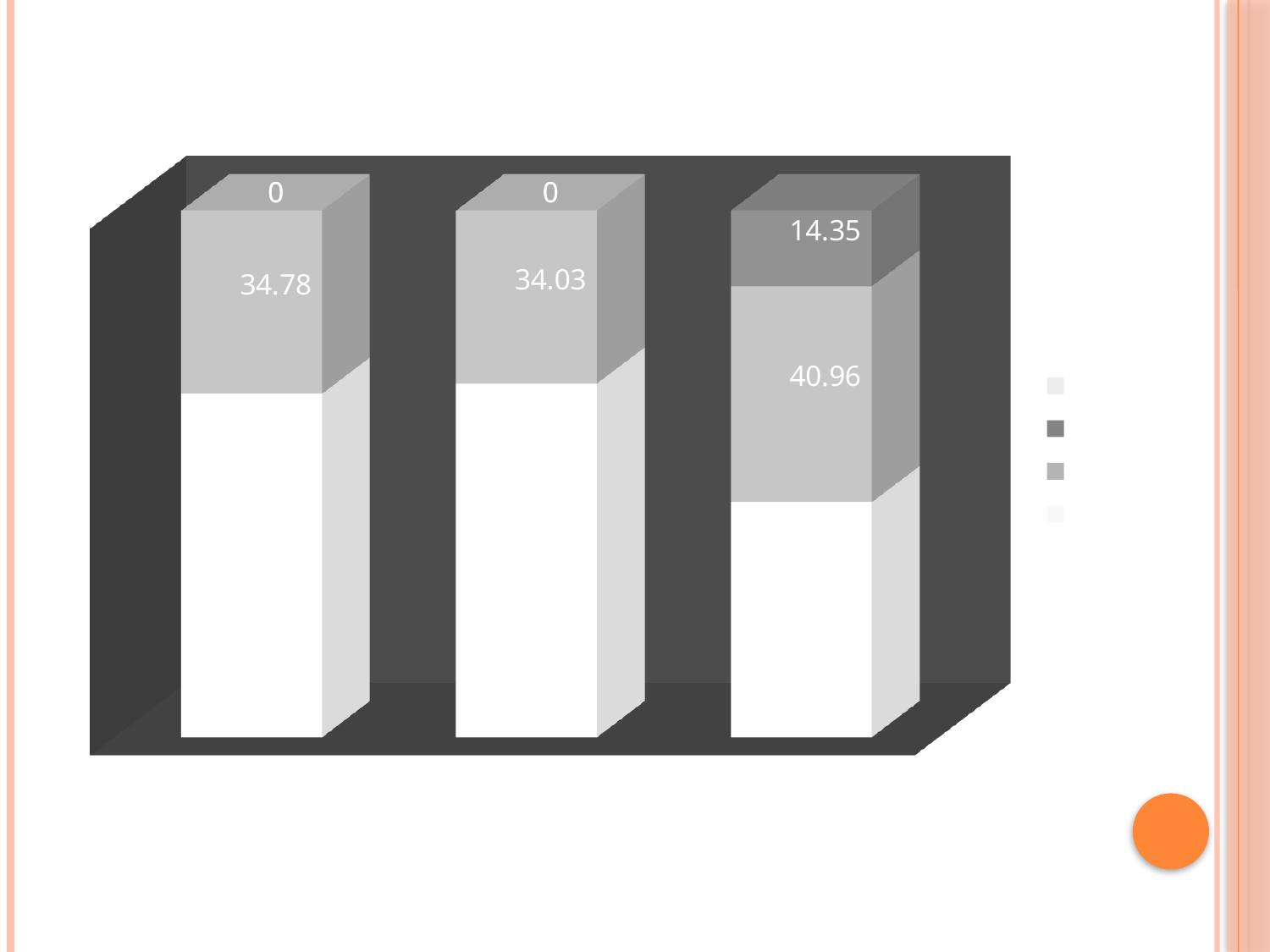
What is the difference between the light grey segment values of the right bar (40.96) and the left bar (34.78)? 6.18 What is the value labelled on the light grey segment of the middle bar? 34.03 Which bar has the lowest labelled light grey segment value? the middle bar Which is larger: the light grey segment value of the left bar or of the middle bar? the left bar How many entries does the legend on the right of the chart show? 4 What kind of chart is shown on the slide? bar chart Which bar has the highest labelled light grey segment value? the right bar How many bars are plotted in the chart? 3 What is the value labelled on the light grey segment of the right bar? 40.96 What is the value labelled on the dark grey top segment of the right bar? 14.35 What value is labelled at the top of the left bar? 0 What is the value labelled on the light grey segment of the left bar? 34.78